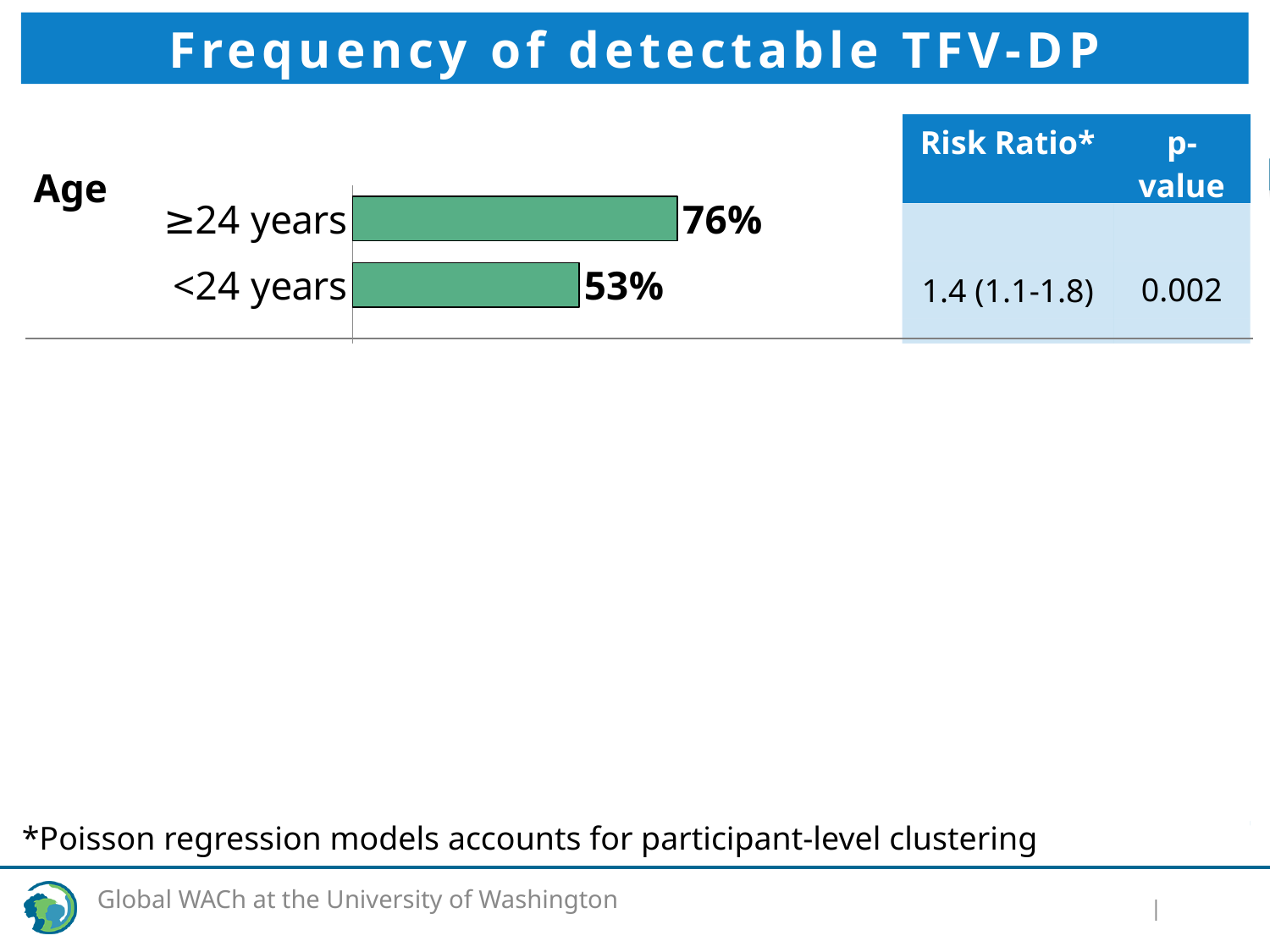
How many age categories are shown in the chart? 2 What kind of chart is used to show the frequency of detectable TFV-DP? bar chart Is the value for ≥24 years larger or smaller than the value for <24 years? larger What is the difference in percentage points between the ≥24 years and <24 years groups? 23 percentage points What is the title of the slide containing the chart? Frequency of detectable TFV-DP What colour are the bars in the chart? green What is the frequency of detectable TFV-DP for participants aged <24 years? 53% Which age group has the lower frequency of detectable TFV-DP? <24 years What is the frequency of detectable TFV-DP for participants aged ≥24 years? 76% Which age group has the higher frequency of detectable TFV-DP? ≥24 years